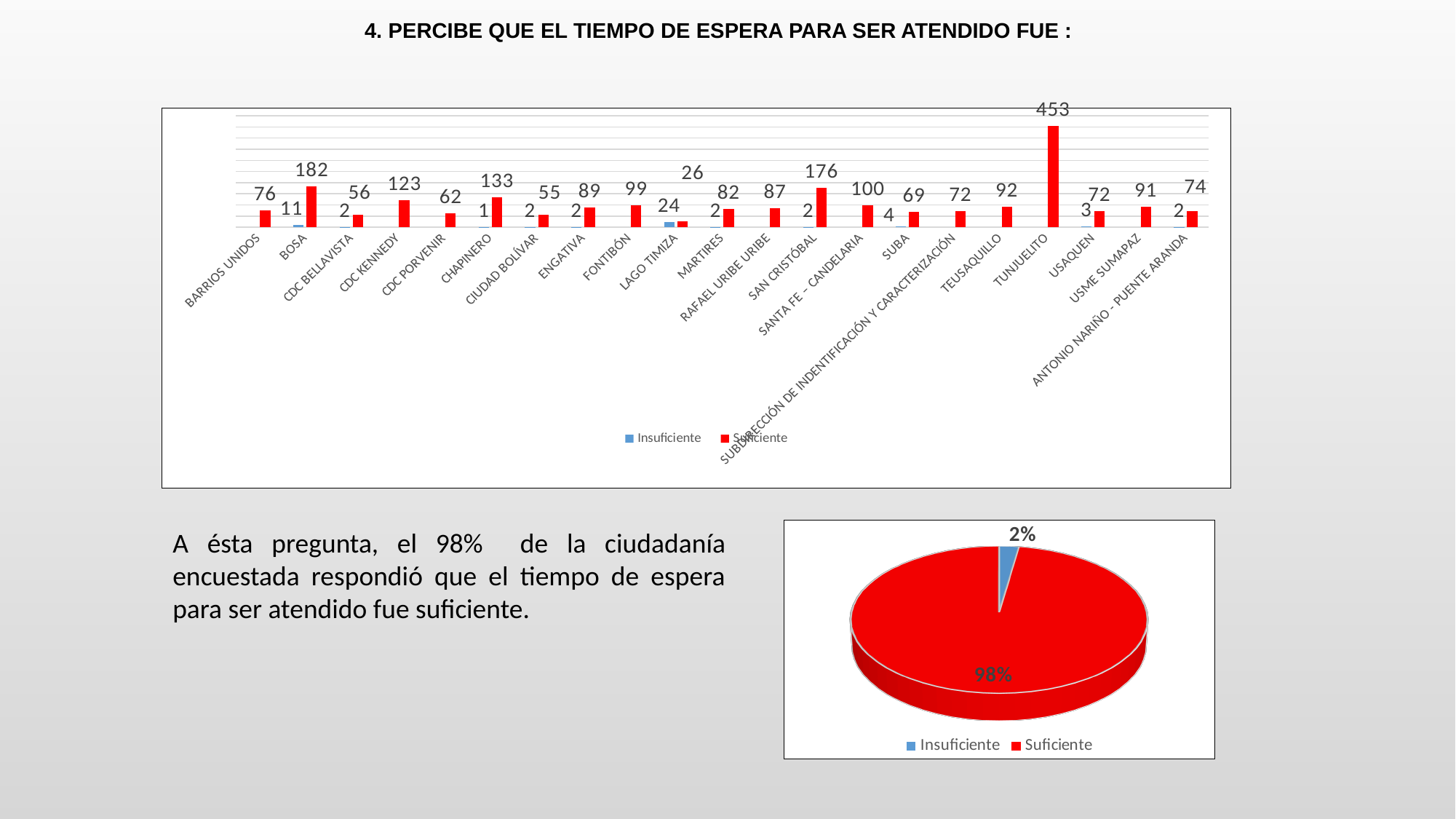
In the top bar chart, what is the Insuficiente value for LAGO TIMIZA? 24 How many series does the legend of the top bar chart list? 2 In the pie chart at the bottom right, what share does Suficiente have? 98% In the top bar chart, what is the Insuficiente value for BOSA? 11 In the top bar chart, what is the Suficiente value for TUNJUELITO? 453 In the top bar chart, which category has the lowest Suficiente value? LAGO TIMIZA How many categories are shown on the x axis of the top bar chart? 21 In the top bar chart, which has a larger Suficiente value, CDC KENNEDY or CHAPINERO? CHAPINERO In the top bar chart, which category has the highest Suficiente value? TUNJUELITO In the top bar chart, what is the total of the Insuficiente and Suficiente values for LAGO TIMIZA? 50 In the top bar chart, what is the difference between the Suficiente values for BOSA and SAN CRISTÓBAL? 6 What kind of chart is the top chart on the slide? Bar chart